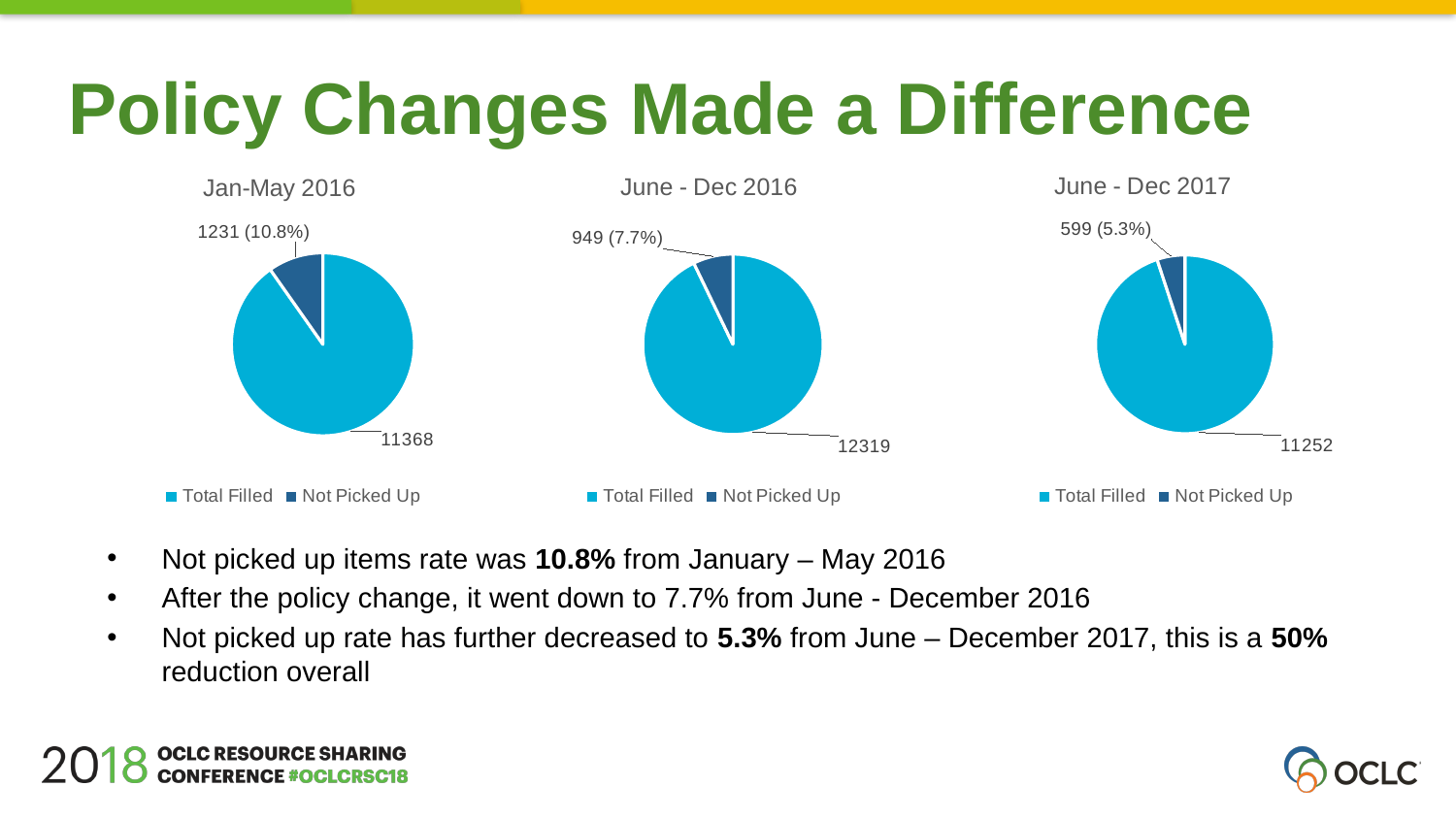
In the June - Dec 2016 chart, which slice is larger, Total Filled or Not Picked Up? Total Filled In the June - Dec 2016 chart, what is the value for Not Picked Up? 949 (7.7%) What kind of chart is used on this slide? pie chart In the June - Dec 2017 chart, what is the value for Not Picked Up? 599 (5.3%) In the June - Dec 2016 chart, what is the value for Total Filled? 12319 In the Jan-May 2016 chart, what is the value for Not Picked Up? 1231 (10.8%) In the Jan-May 2016 chart, what is the value for Total Filled? 11368 How many series does the legend of the Jan-May 2016 chart list? 2 In the June - Dec 2017 chart, what share of the pie is Not Picked Up? 5.3% In the June - Dec 2017 chart, what is the value for Total Filled? 11252 How many pie charts are on the slide? 3 What is the difference between the Total Filled value and the Not Picked Up value in the Jan-May 2016 chart? 10137